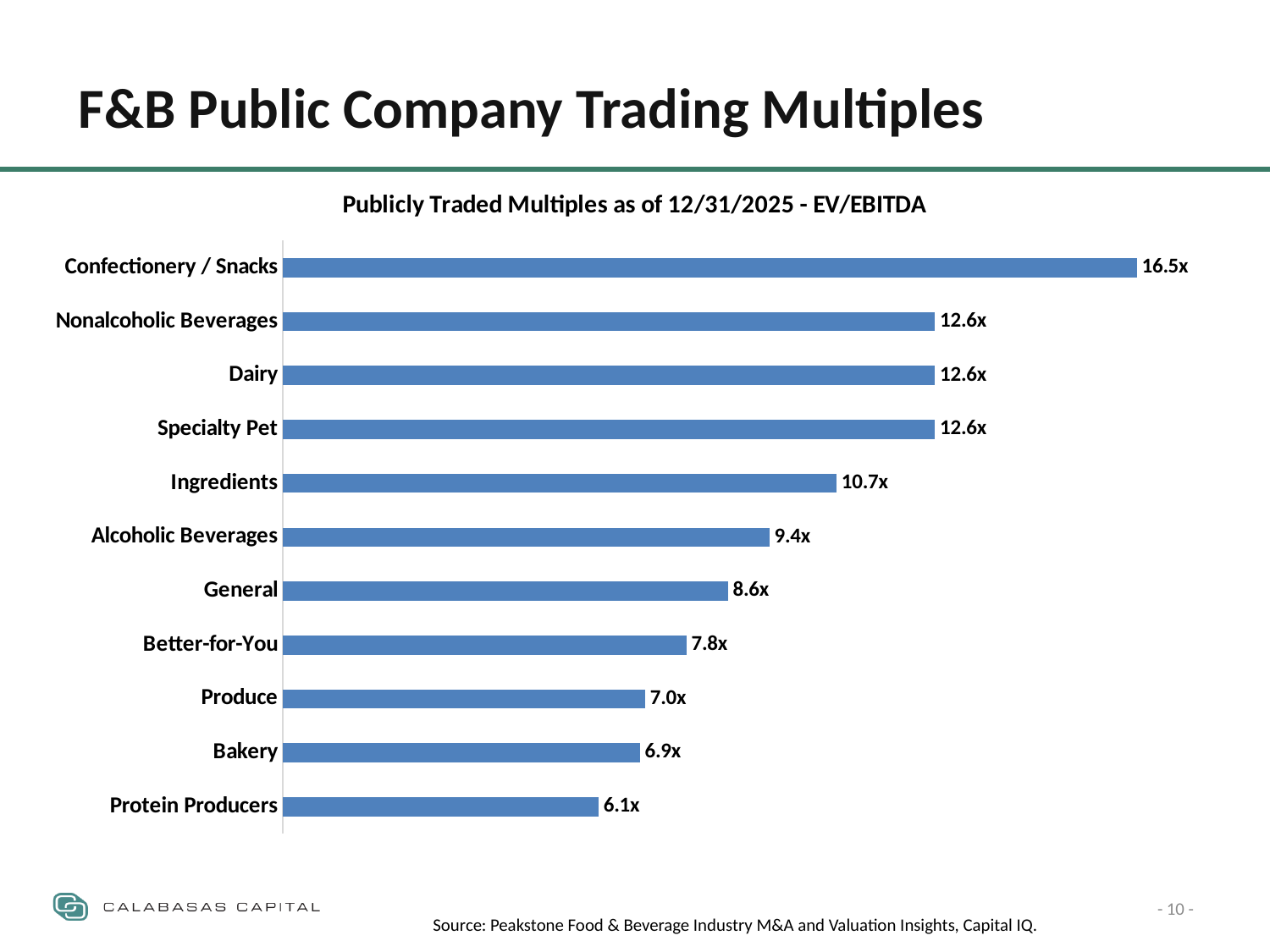
What is the EV/EBITDA multiple for Confectionery / Snacks? 16.5x What is the EV/EBITDA multiple for Protein Producers? 6.1x What is the difference between the multiples for Alcoholic Beverages and General? 0.8x Which has a higher EV/EBITDA multiple, Ingredients or Alcoholic Beverages? Ingredients Which category has the lowest EV/EBITDA multiple? Protein Producers Which category has the highest EV/EBITDA multiple? Confectionery / Snacks What is the EV/EBITDA multiple for Ingredients? 10.7x How many categories are shown in the chart? 11 What is the title of the chart? Publicly Traded Multiples as of 12/31/2025 - EV/EBITDA What is the difference between the multiples for Confectionery / Snacks and Dairy? 3.9x What is the EV/EBITDA multiple for Better-for-You? 7.8x What type of chart is shown on the slide? Bar chart